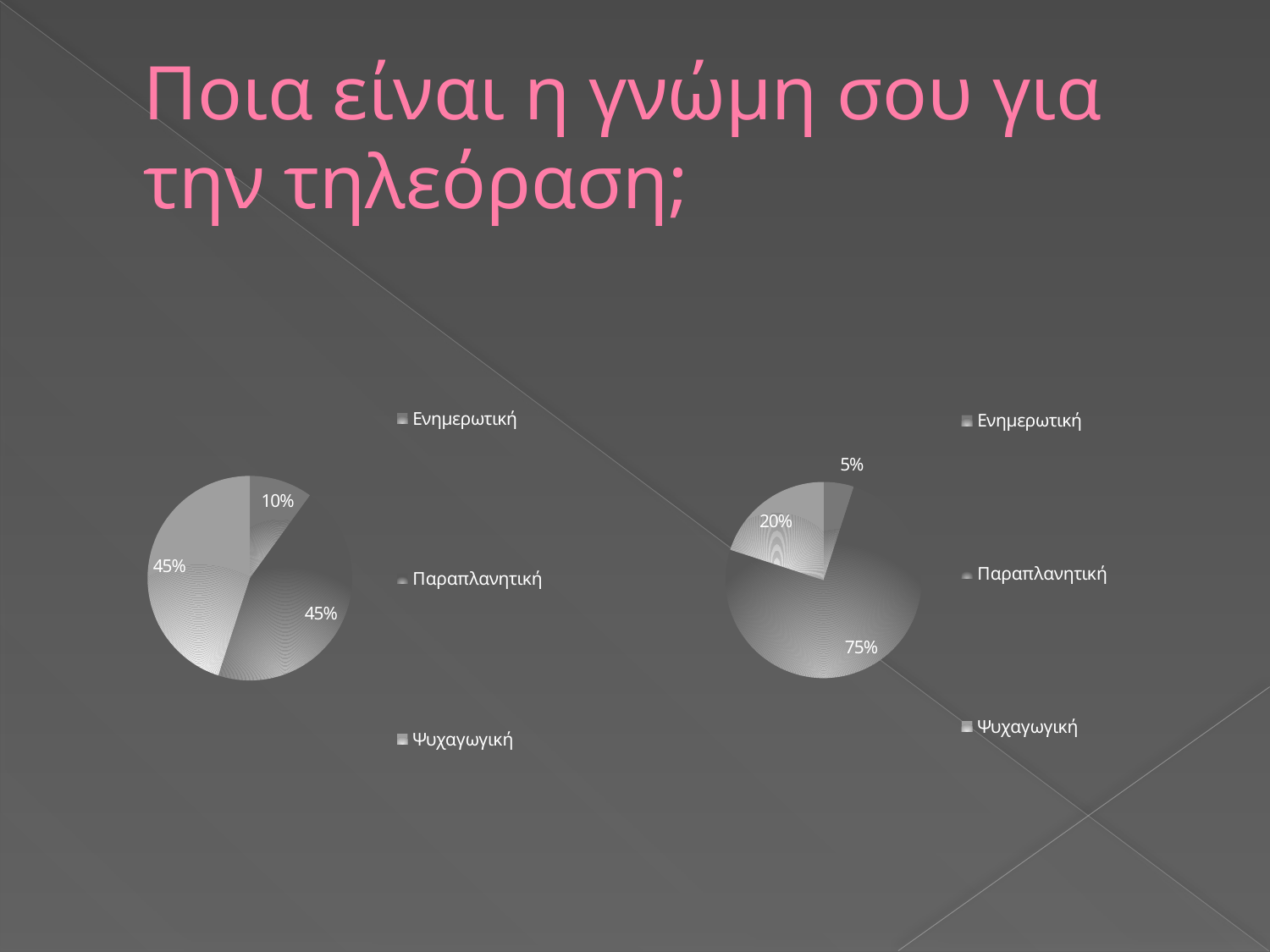
In the right pie chart, what is the difference between the largest slice (75%) and the 20% slice? 55% In the right pie chart, how many entries does the legend list? 3 In the right pie chart, what is the largest slice's value? 75% In the right pie chart, what is the value for Παραπλανητική? 75% In the left pie chart, how many slices are there? 3 In the right pie chart, what is the smallest slice's value? 5% What kind of charts are shown on the slide? Pie charts How many pie charts are on the slide? 2 What is the first legend entry listed for the left pie chart? Ενημερωτική In the right pie chart, what is the value for Ψυχαγωγική? 20% In the left pie chart, what is the smallest slice's value? 10% In the left pie chart, what is the value for Ενημερωτική? 10%